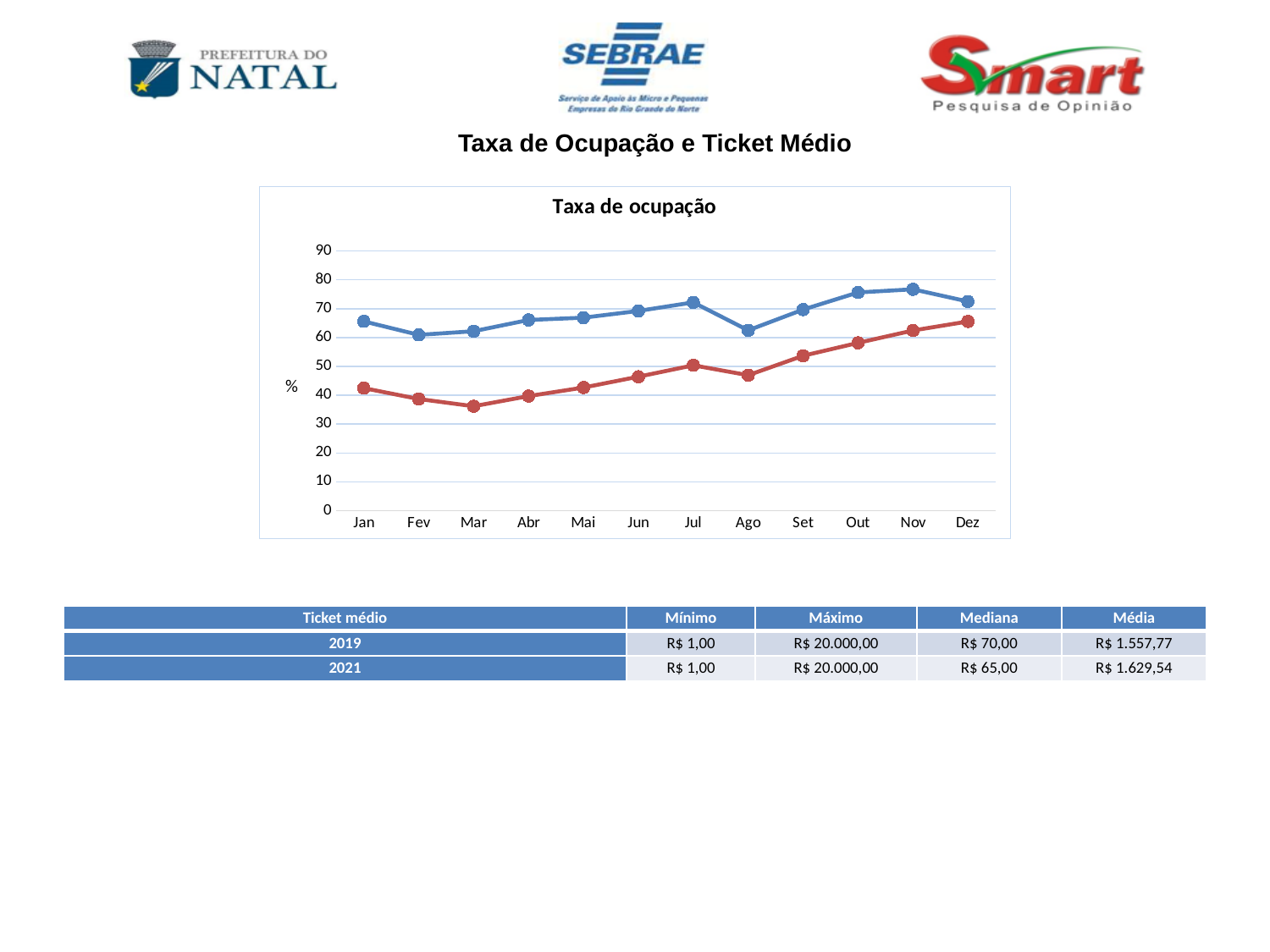
In which month does the red line reach its highest value? Dez Does the red line generally rise or fall from Mar to Dez? Rise How many months are plotted along the x axis of the chart? 12 In Jan, which line has the higher value, the blue line or the red line? Blue line What kind of chart is shown on the slide? Line chart Is the value of the red line in Mar greater or less than 40? less Is the value of the blue line in Jan greater or less than 60? greater What is the title of the chart? Taxa de ocupação How many lines (series) are plotted in the chart? 2 Is the value of the blue line in Ago greater or less than 70? less What label is shown on the vertical axis of the chart? % In which month does the red line reach its lowest value? Mar